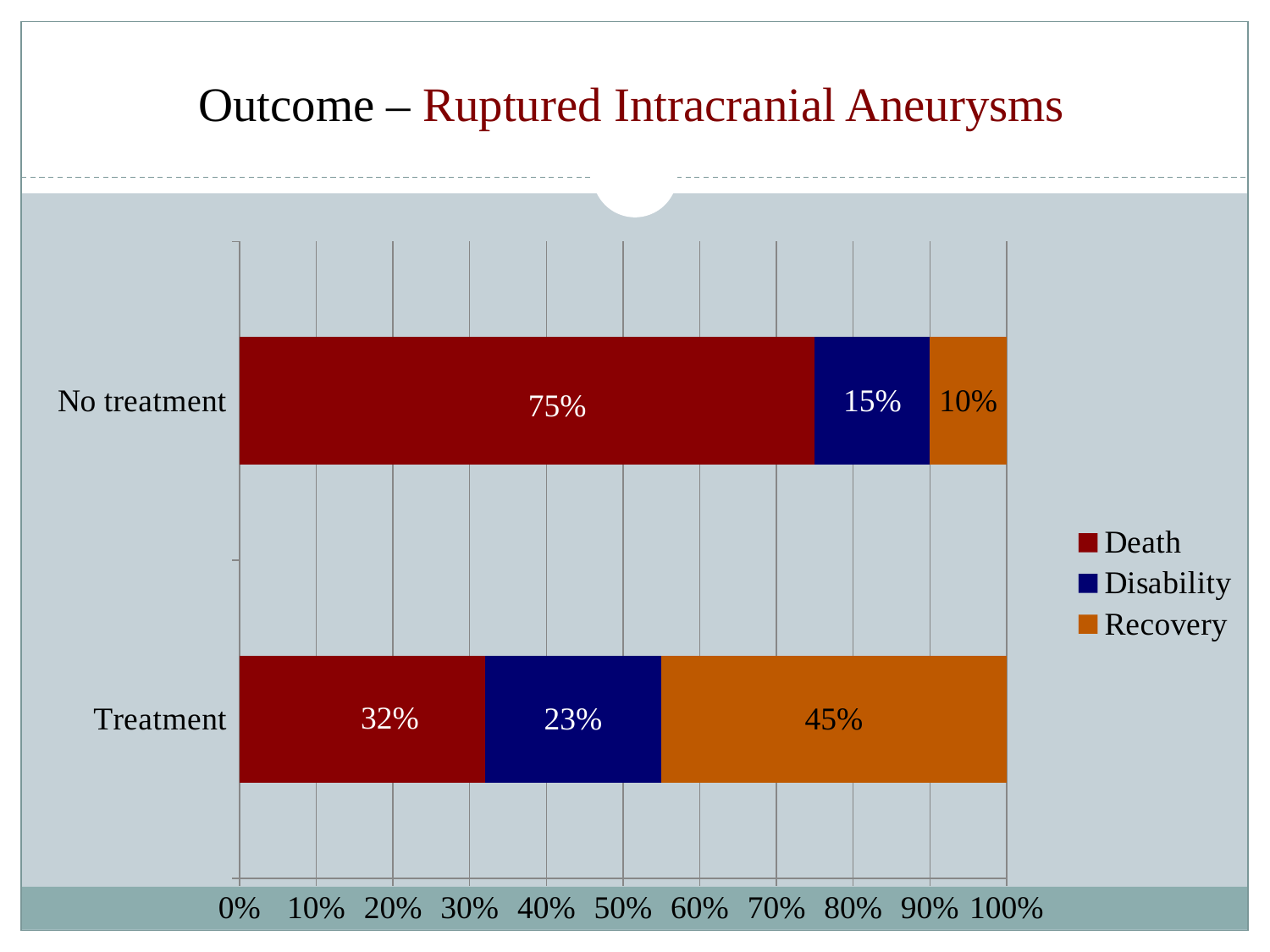
What is the difference between the Death values for No treatment and Treatment? 43% Which outcome has the smallest share in the No treatment bar? Recovery What is the Recovery value for the Treatment bar? 45% What is the Recovery value for the No treatment bar? 10% How many series does the legend list? 3 What kind of chart is shown on the slide? Stacked bar chart Which outcome has the largest share in the Treatment bar? Recovery Which category has the higher Death value, No treatment or Treatment? No treatment What is the Disability value for the Treatment bar? 23% What is the Death value for the No treatment bar? 75% What is the difference between the Recovery values for Treatment and No treatment? 35% How many categories are shown on the chart? 2